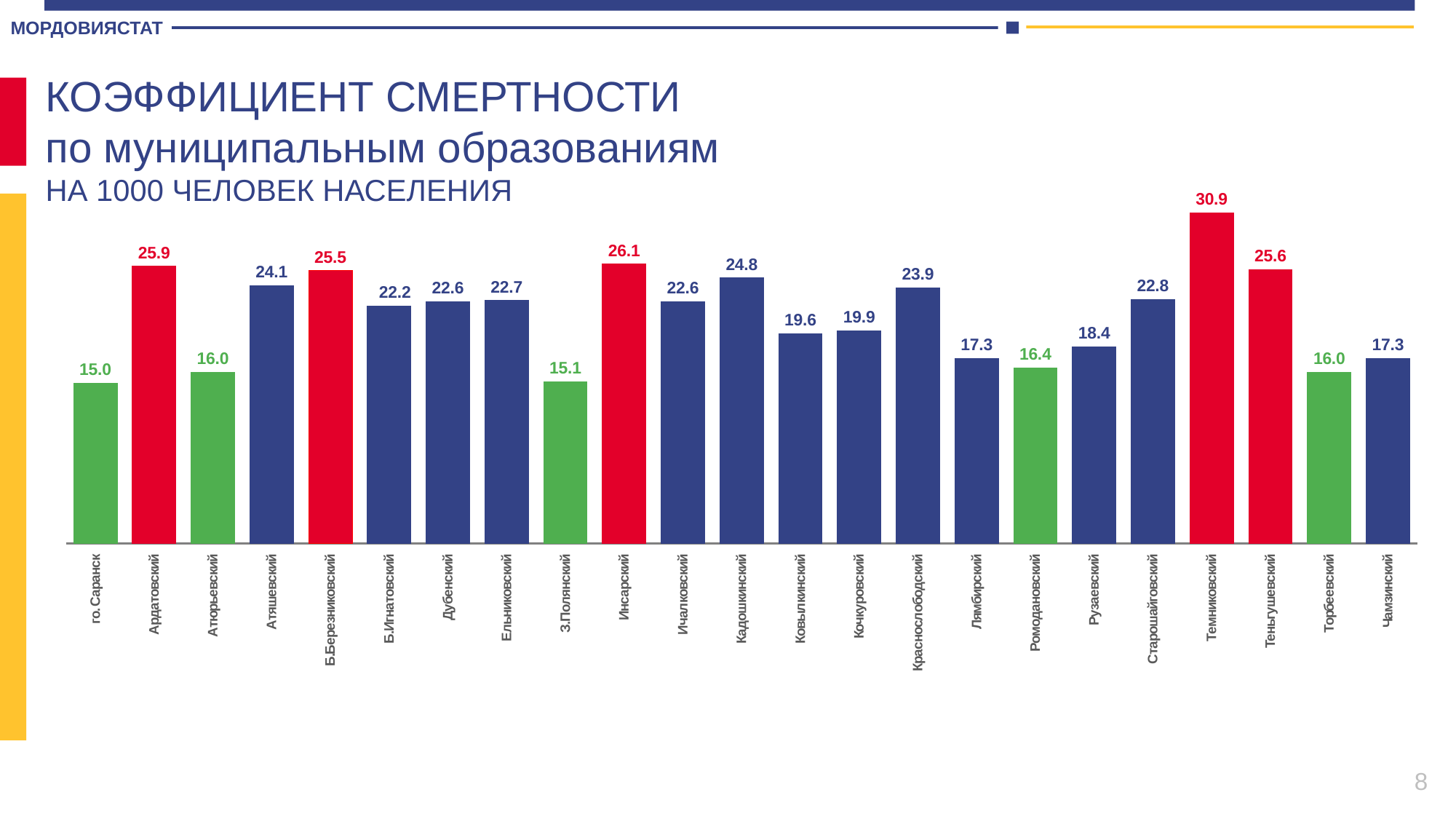
Which municipality has the lowest mortality rate? го.Саранск What is the difference between the values for Темниковский and Инсарский? 4.8 What is the value shown for Кадошкинский? 24.8 What colour are the bars for the municipalities with the highest values, such as Темниковский and Инсарский? Red How many municipalities are shown on the chart? 23 What is the value shown for Ромодановский? 16.4 Which municipality has the highest mortality rate? Темниковский What type of chart is shown on the slide? Bar chart What is the mortality rate for Темниковский? 30.9 What is the difference between the values for Ардатовский and Атюрьевский? 9.9 Which has a higher value, Краснослободский or Старошайговский? Краснослободский What is the value shown for го.Саранск? 15.0